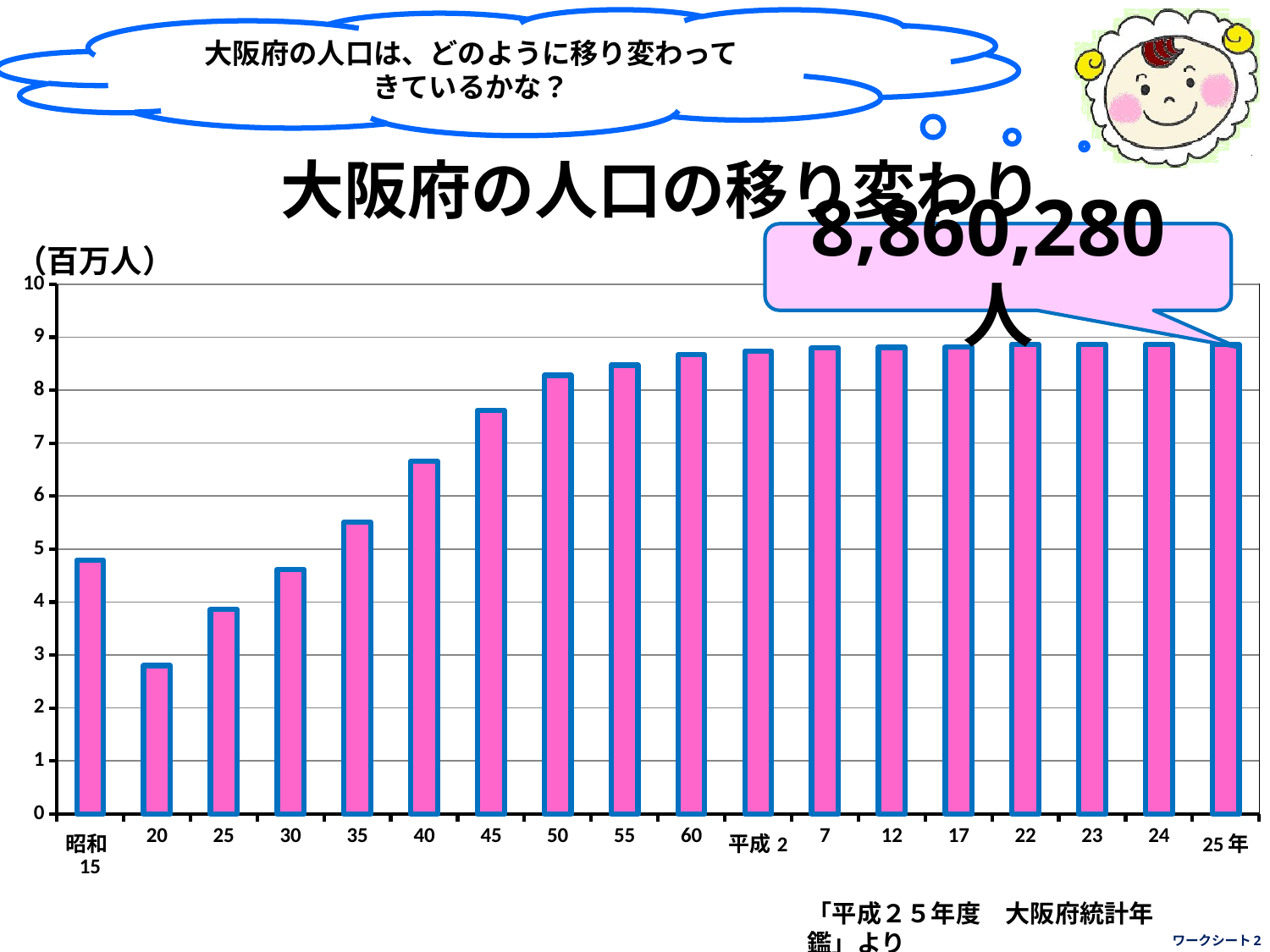
What population value is shown in the callout for 平成25年? 8,860,280人 How many bars (years) are plotted in the chart? 18 Which year has the lowest population in the chart? 昭和20 Which is larger, the value for 昭和25 or the value for 昭和30? 昭和30 What unit is shown for the vertical axis of the chart? 百万人 What kind of chart is shown on the slide? Bar chart What is the title of the chart? 大阪府の人口の移り変わり Is the value for 昭和45 greater or less than 7? greater From 昭和20 onward, do the values generally rise or fall along the x axis? rise Is the value for 昭和35 greater or less than 5? greater Is the value for 昭和20 greater or less than 3? less